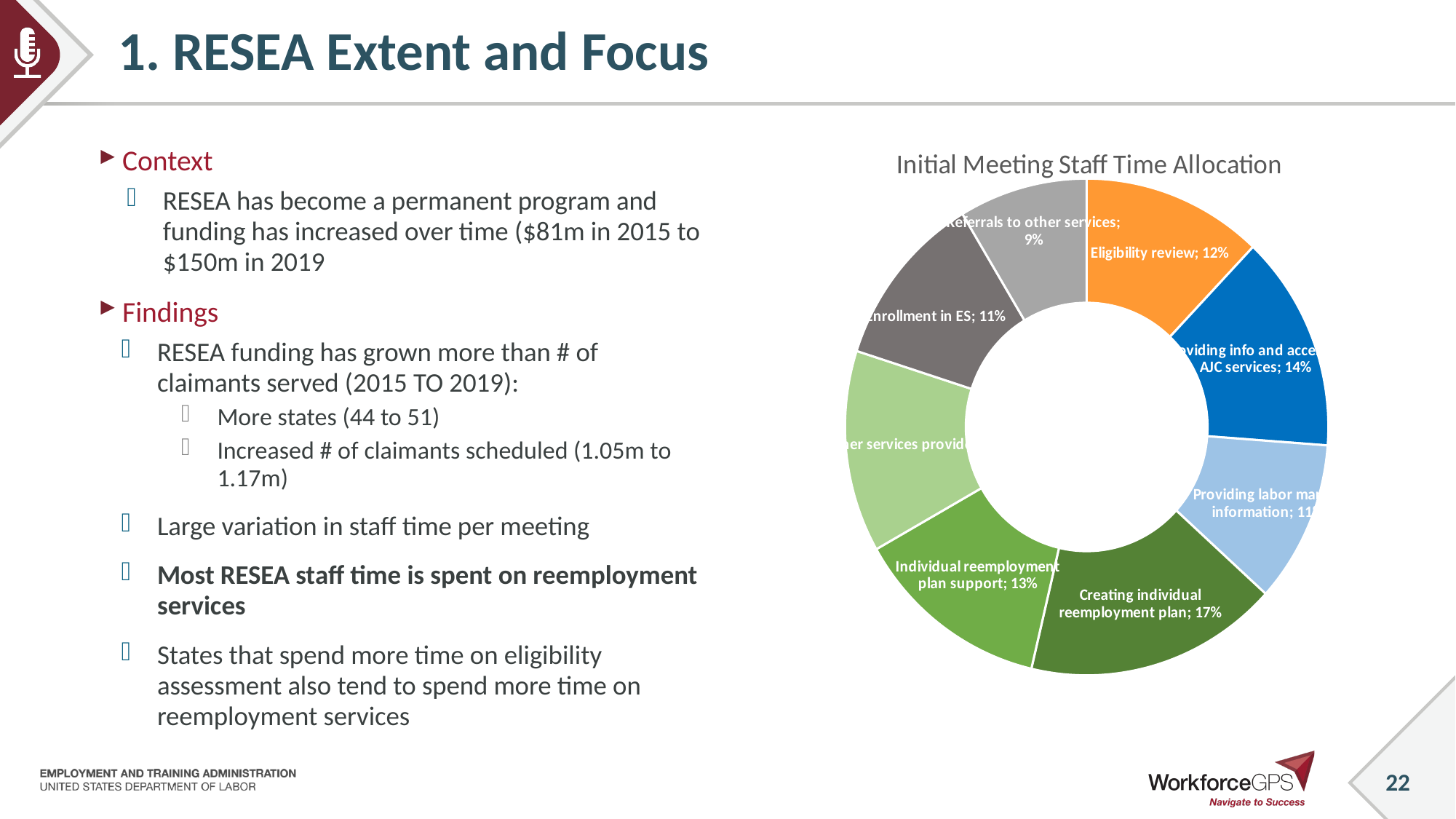
How many slices does the doughnut chart have? 8 What share of staff time is allocated to Enrollment in ES? 11% What share of staff time is allocated to Eligibility review? 12% Which activity has the smallest share of staff time in the chart? Referrals to other services What share of staff time is allocated to Referrals to other services? 9% What share of staff time is allocated to Creating individual reemployment plan? 17% Which activity has the largest share of staff time in the chart? Creating individual reemployment plan What kind of chart is shown on the slide? doughnut chart What is the difference in percentage points between Creating individual reemployment plan and Eligibility review? 5 Which has a larger share of staff time: Individual reemployment plan support or Enrollment in ES? Individual reemployment plan support What is the title of the chart on the slide? Initial Meeting Staff Time Allocation What share of staff time is allocated to Individual reemployment plan support? 13%